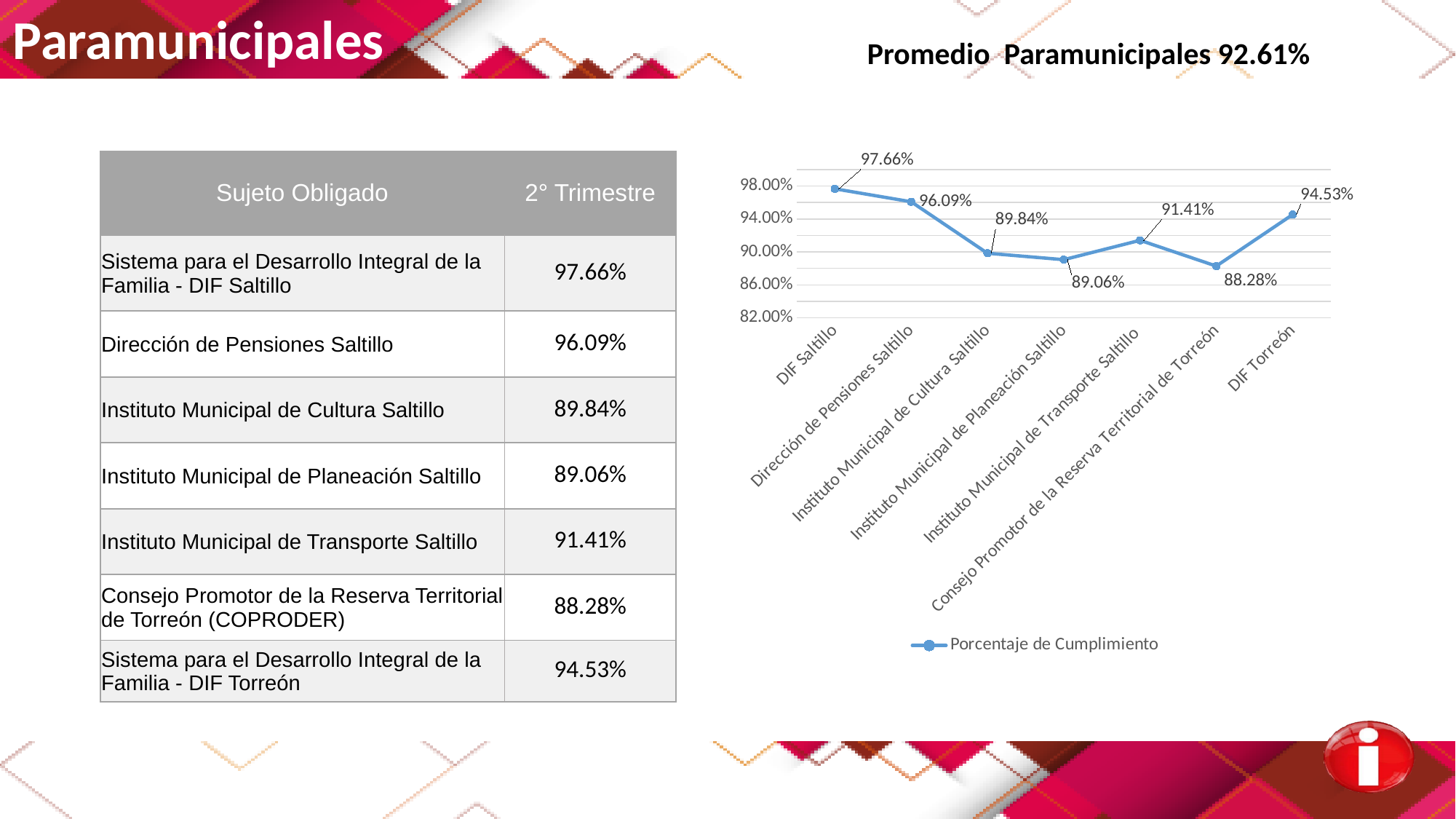
What is the value for DIF Saltillo in the chart? 97.66% Which category has the lowest value in the chart? Consejo Promotor de la Reserva Territorial de Torreón Is the value for Dirección de Pensiones Saltillo greater or less than 94.00%? greater How many series does the chart legend list? 1 What is the difference between the values for DIF Saltillo and DIF Torreón? 3.13% Which is larger, the value for Instituto Municipal de Cultura Saltillo or Instituto Municipal de Planeación Saltillo? Instituto Municipal de Cultura Saltillo What is the name of the series shown in the chart legend? Porcentaje de Cumplimiento What is the value for Instituto Municipal de Transporte Saltillo in the chart? 91.41% What is the value for Consejo Promotor de la Reserva Territorial de Torreón in the chart? 88.28% Which category has the highest value in the chart? DIF Saltillo What type of chart is shown on the slide? line chart How many categories are plotted on the x axis of the chart? 7